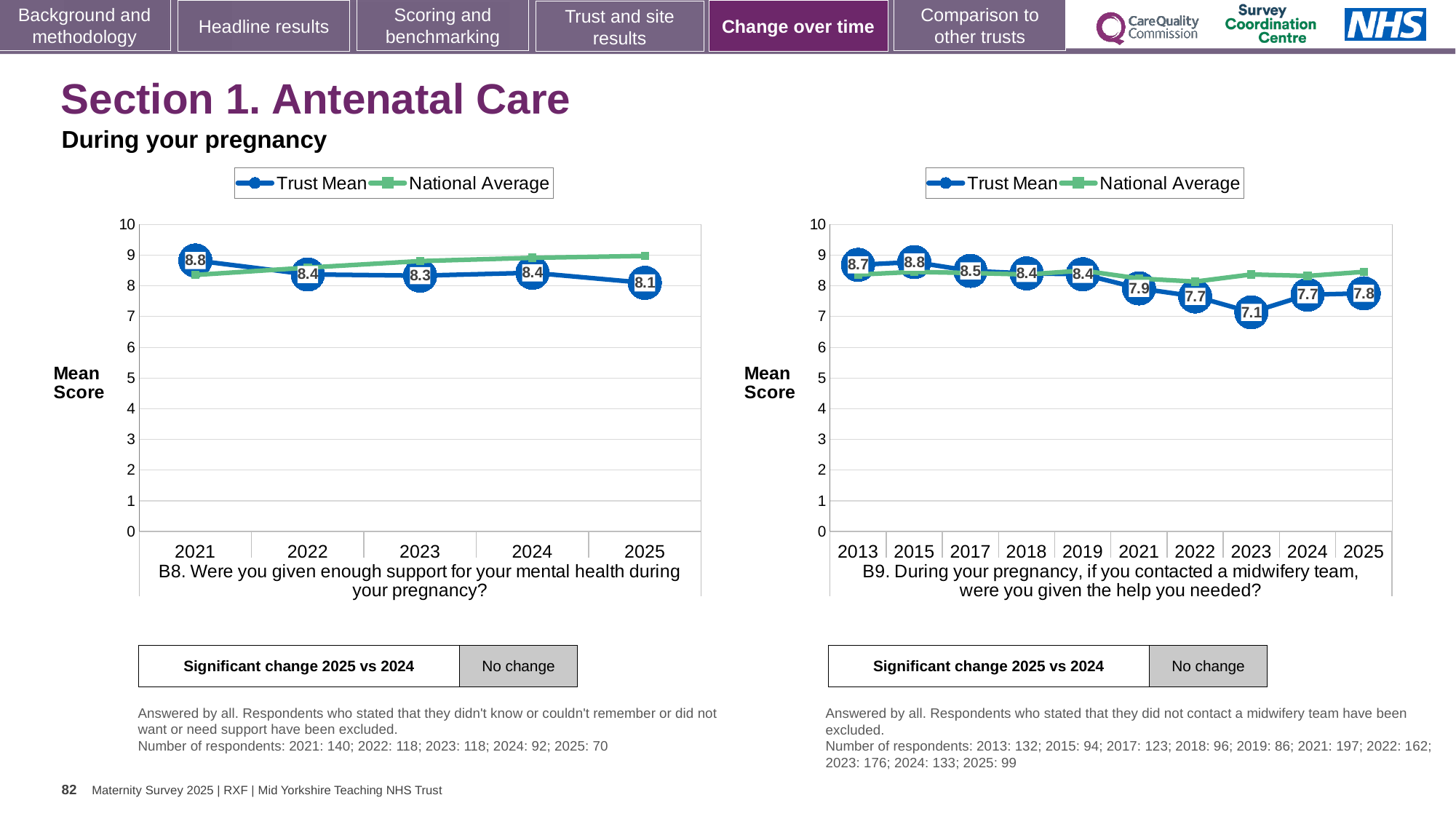
In the B9 chart (right), what is the Trust Mean for 2023? 7.1 In the B9 chart (right), is the Trust Mean higher in 2013 or in 2022? 2013 In the B8 chart (left), how many years are shown on the x axis? 5 In the B9 chart (right), which year has the lowest Trust Mean? 2023 In the B8 chart (left), is the National Average for 2025 greater or less than 8? greater In the B8 chart (left), what is the Trust Mean for 2025? 8.1 In the B8 chart (left), which year has the lowest Trust Mean? 2025 In the B8 chart (left), what is the difference between the Trust Mean in 2021 and in 2025? 0.7 In the B9 chart (right), how many series does the legend list? 2 In the B8 chart (left), what is the Trust Mean for 2021? 8.8 In the B9 chart (right), which year has the highest Trust Mean? 2015 What type of chart is the B9 chart (right)? Line chart